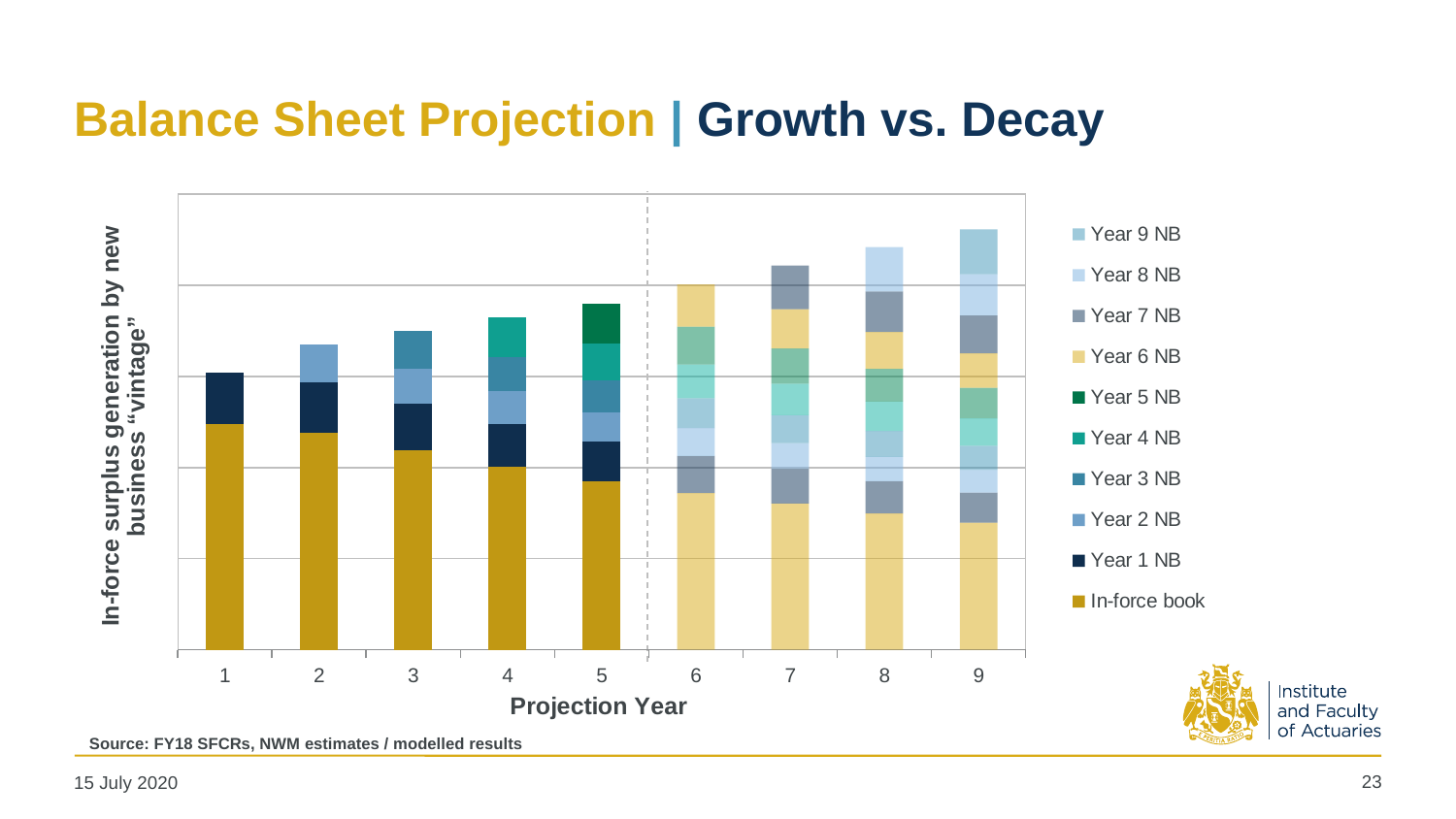
How many series does the chart's legend list? 10 How many projection years are shown on the x axis of the chart? 9 Which is taller overall, the stacked bar for projection year 9 or the stacked bar for projection year 1? Projection year 9 Does the In-force book segment get larger or smaller as the projection year increases? Smaller Which legend entry is shown at the bottom of the legend? In-force book Which projection year has the shortest stacked bar overall? 1 Which is taller overall, the stacked bar for projection year 5 or the stacked bar for projection year 2? Projection year 5 Which projection year has the tallest stacked bar overall? 9 What kind of chart is shown on the slide? Stacked bar chart What is the title of the x axis of the chart? Projection Year Does the total height of the stacked bars rise or fall as the projection year increases from 1 to 9? Rise